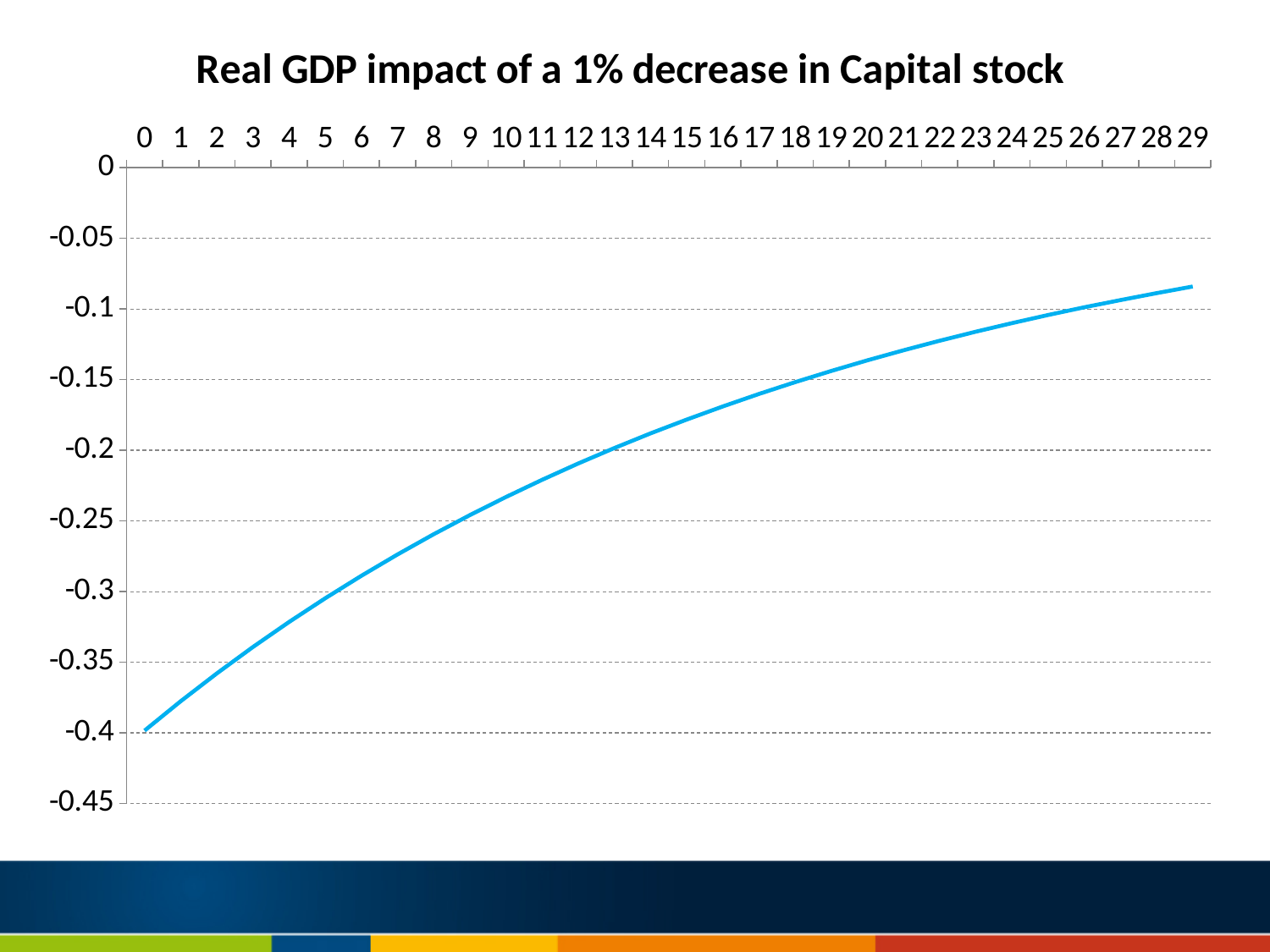
Is the value at x = 15 greater or less than -0.2? greater Which is larger, the value at x = 5 or the value at x = 25? x = 25 At which x value is the line at its highest point? 29 Do the values rise or fall as you move from 0 to 29 along the x axis? rise What kind of chart is shown on the slide? line chart At which x value is the line at its lowest point? 0 How many x-axis points are labelled on the chart? 30 Is the value at x = 1 greater or less than -0.35? less Is the value at x = 29 greater or less than -0.1? greater What is the title of the chart? Real GDP impact of a 1% decrease in Capital stock